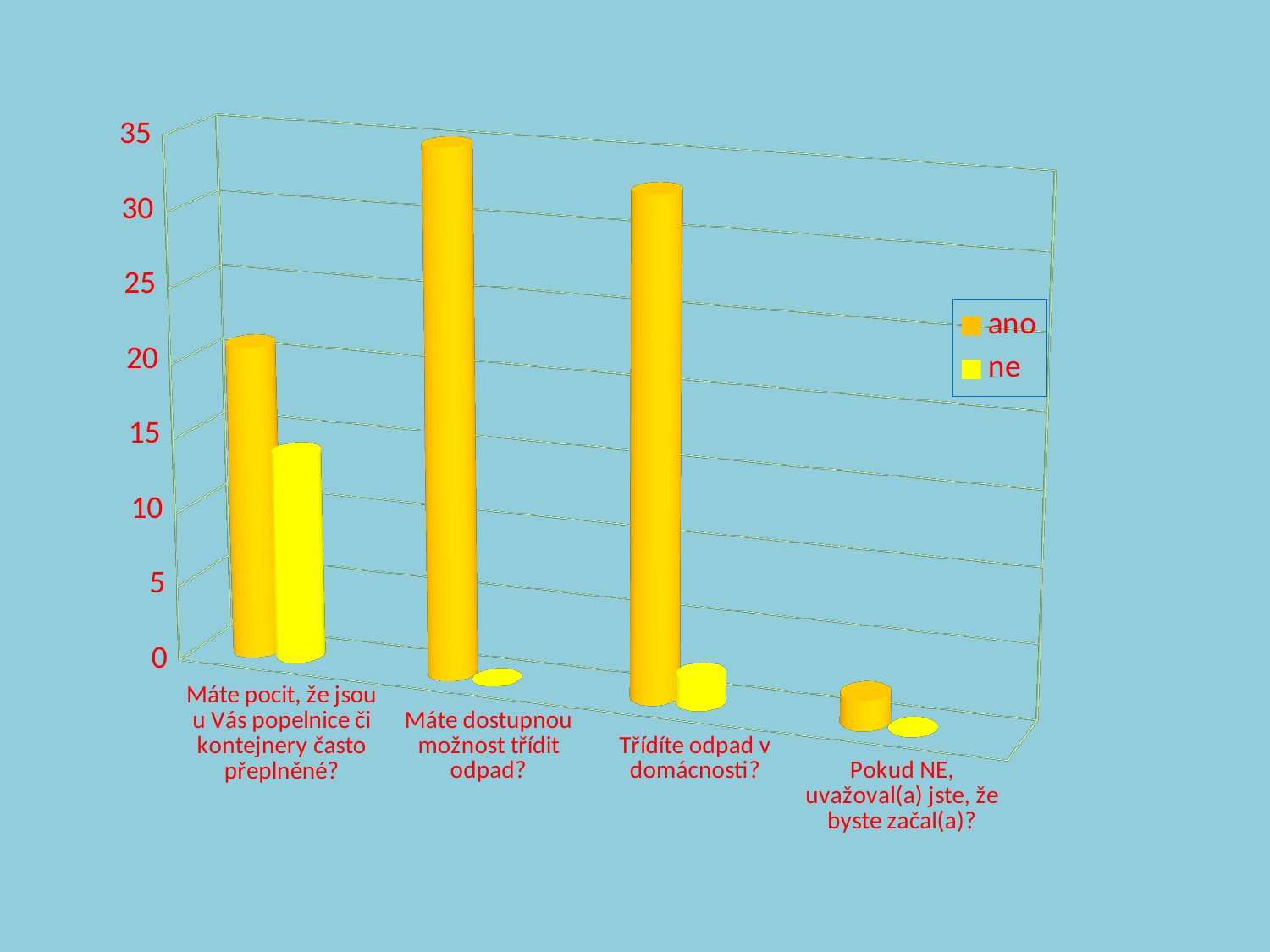
For "Máte pocit, že jsou u Vás popelnice či kontejnery často přeplněné?", which series has the larger value, "ano" or "ne"? ano Is the "ano" value for "Máte dostupnou možnost třídit odpad?" greater or less than 30? greater Is the "ne" value for "Máte pocit, že jsou u Vás popelnice či kontejnery často přeplněné?" greater or less than 20? less Which category has the highest value for the "ne" series? Máte pocit, že jsou u Vás popelnice či kontejnery často přeplněné? How many question categories are shown on the x axis? 4 Which category has the lowest value for the "ano" series? Pokud NE, uvažoval(a) jste, že byste začal(a)? Which category has the highest value for the "ano" series? Máte dostupnou možnost třídit odpad? What kind of chart is shown on the slide? bar chart Is the "ano" value for "Třídíte odpad v domácnosti?" greater or less than 25? greater What are the two entries listed in the legend? ano, ne How many series does the legend list? 2